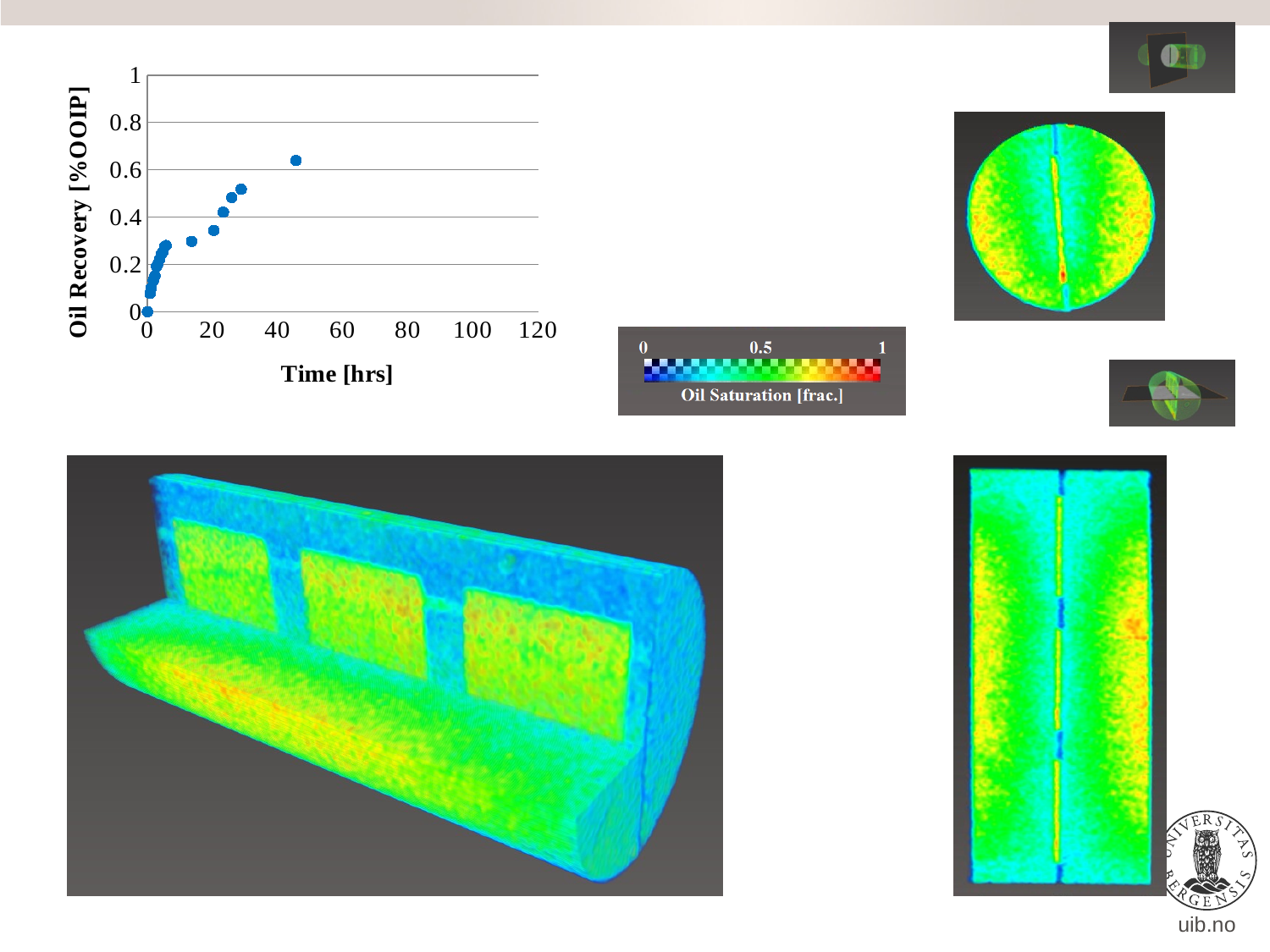
Is the oil recovery value of the point at roughly 13 hrs greater or less than 0.2? greater Is the oil recovery value of the last (rightmost) point greater or less than 0.8? less What is the highest tick value shown on the x axis? 120 Is the time of the last (rightmost) point greater or less than 60 hrs? less Do the oil recovery values rise or fall as time increases along the x axis? rise What is the highest tick value shown on the y axis? 1 What kind of chart is shown on the slide? scatter chart What is the label of the x axis of the chart? Time [hrs] What is the label of the y axis of the chart? Oil Recovery [%OOIP]